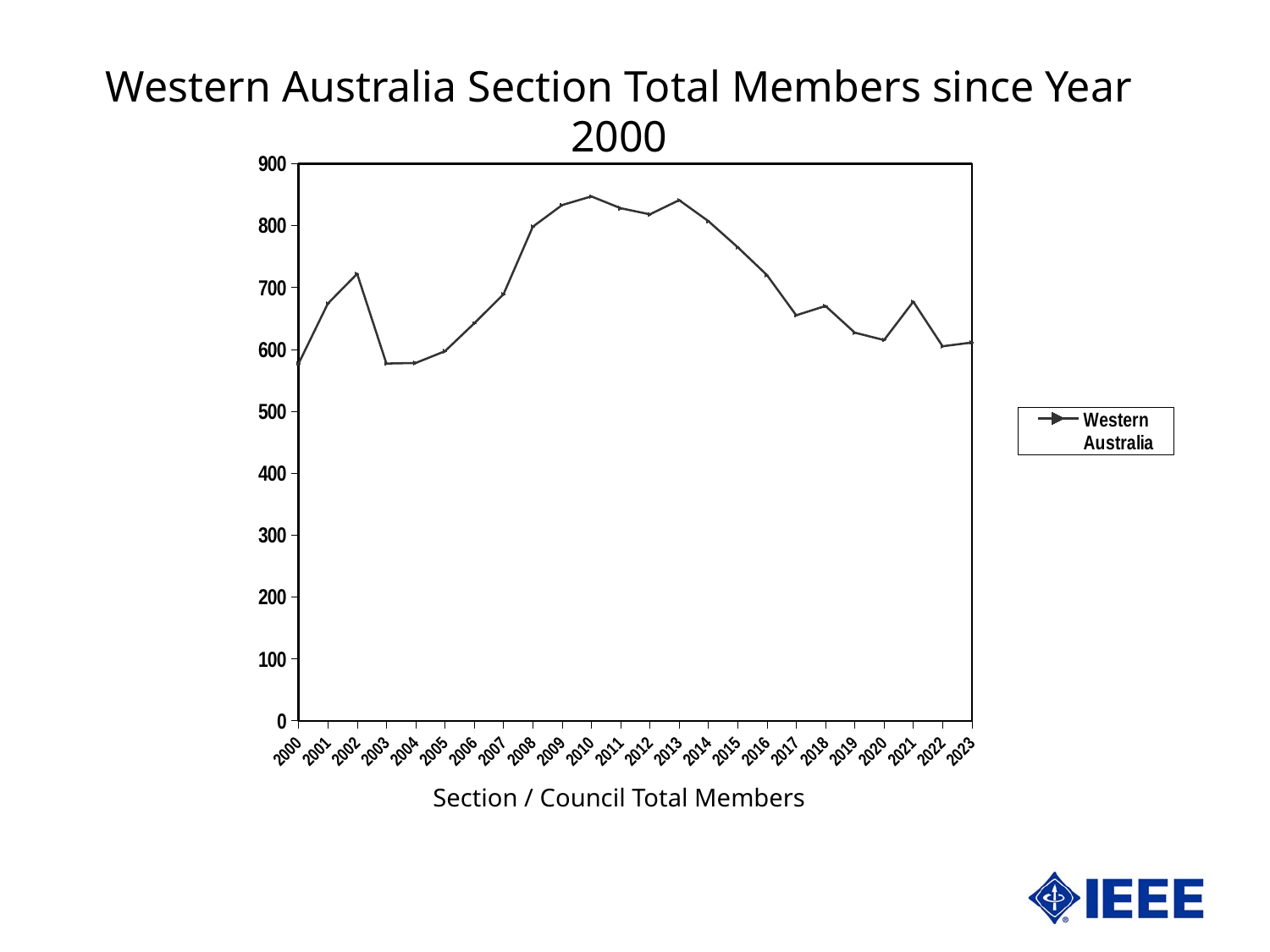
Do the values rise or fall from 2013 to 2017? fall Is the value for 2002 greater or less than 700? greater What kind of chart is shown on the slide? line chart Is the value for 2010 greater or less than 800? greater How many years are plotted along the x axis? 24 Which year has the larger value, 2010 or 2020? 2010 Which year has the larger value, 2002 or 2003? 2002 Do the values rise or fall from 2004 to 2010? rise What series name is shown in the legend? Western Australia Is the value for 2017 greater or less than 700? less How many series does the legend list? 1